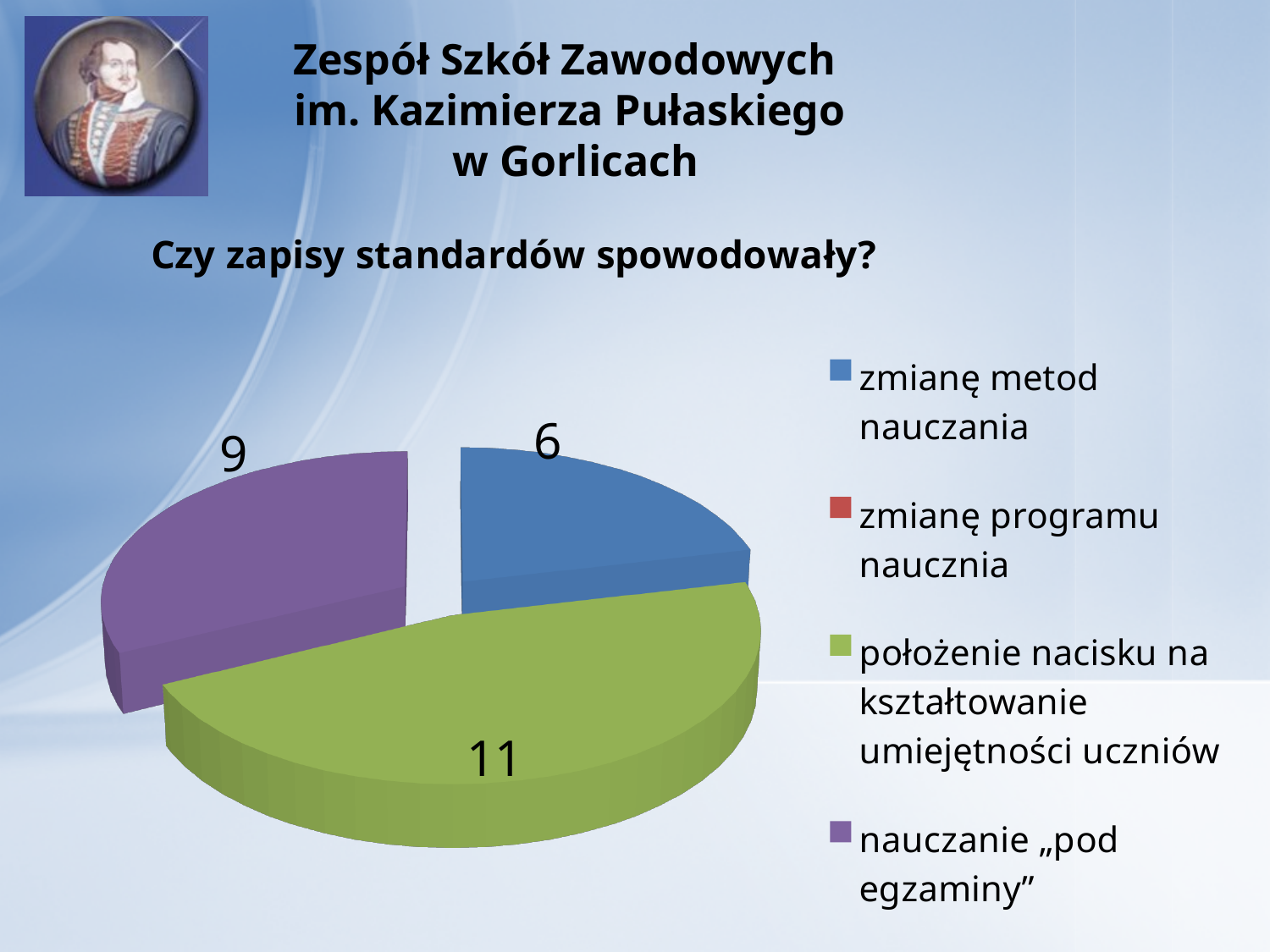
What type of chart is shown on the slide? pie chart What is the value for "nauczanie „pod egzaminy”"? 9 What is the value for "zmianę metod nauczania"? 6 Which category has the largest slice of the pie? położenie nacisku na kształtowanie umiejętności uczniów What is the difference between the values for "nauczanie „pod egzaminy”" and "zmianę metod nauczania"? 3 What question is written above the chart? Czy zapisy standardów spowodowały? How many slices with data labels are visible in the pie? 3 What is the difference between the values for "położenie nacisku na kształtowanie umiejętności uczniów" and "zmianę metod nauczania"? 5 Which of the labelled slices is the smallest? zmianę metod nauczania Which is larger: the value for "nauczanie „pod egzaminy”" or the value for "zmianę metod nauczania"? nauczanie „pod egzaminy” What is the value for "położenie nacisku na kształtowanie umiejętności uczniów"? 11 How many entries does the legend list? 4